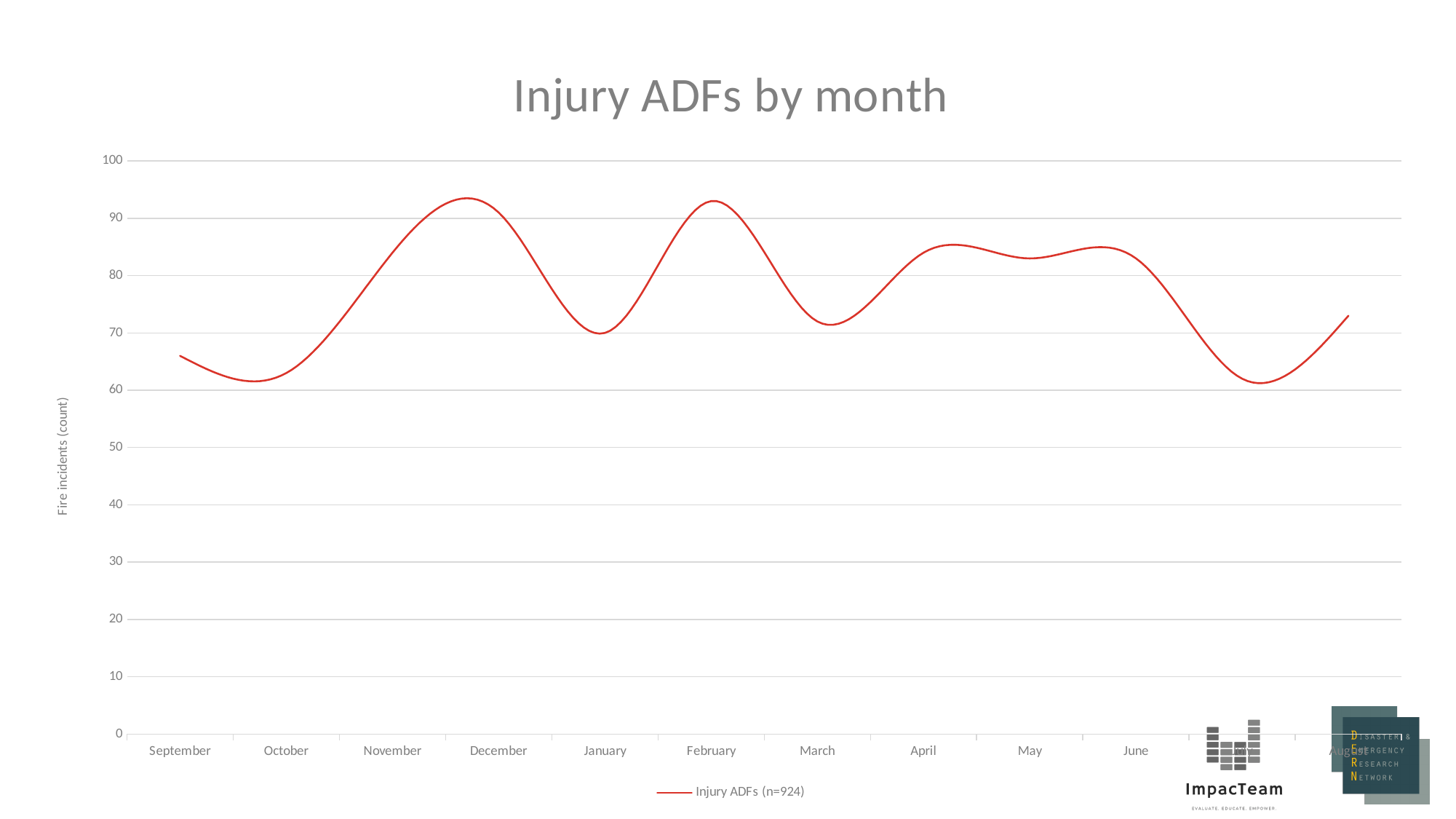
Which is larger, the value for October or the value for April? April Is the value for January greater or less than 80? less Is the value for February greater or less than 90? greater What kind of chart is shown on the slide? line chart Is the value for April greater or less than 80? greater What is the legend entry for the plotted series? Injury ADFs (n=924) Which is larger, the value for December or the value for January? December What is the label on the vertical axis? Fire incidents (count) Does the line rise or fall from October to December? rise How many series does the legend list? 1